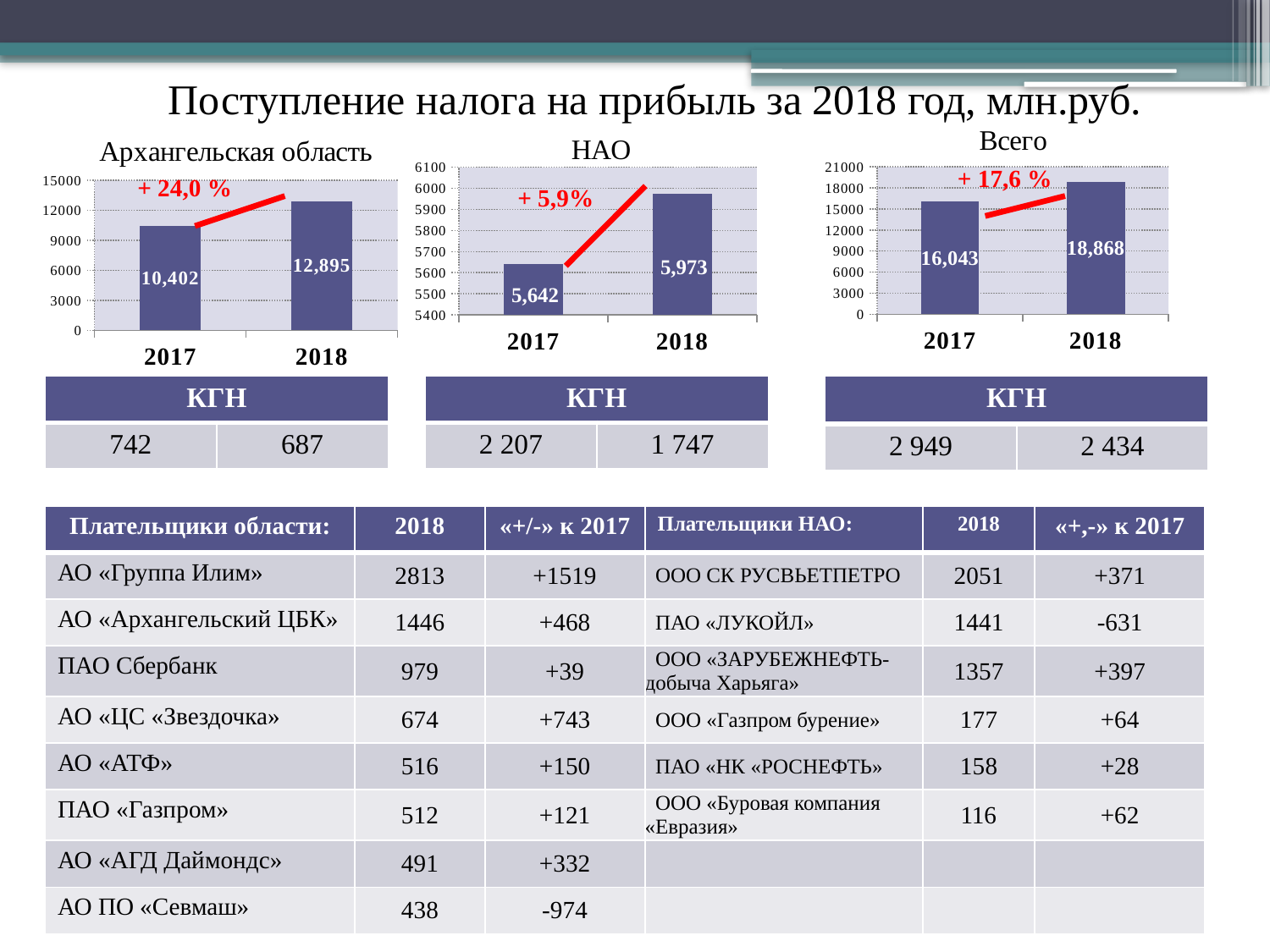
In the "Всего" chart, what is the difference between the 2018 and 2017 values? 2,825 In the "Архангельская область" chart, what is the value for 2018? 12,895 In the "Архангельская область" chart, what is the value for 2017? 10,402 In the "Всего" chart, which year has the lowest value? 2017 What percentage change is annotated on the "Всего" chart? + 17,6 % In the "Архангельская область" chart, do the values rise or fall from 2017 to 2018? rise In the "Архангельская область" chart, what is the difference between the 2018 and 2017 values? 2,493 What kind of chart is the "НАО" chart? bar chart In the "НАО" chart, what is the value for 2017? 5,642 In the "НАО" chart, what is the value for 2018? 5,973 In the "НАО" chart, which year has the higher value? 2018 In the "Всего" chart, what is the value for 2018? 18,868